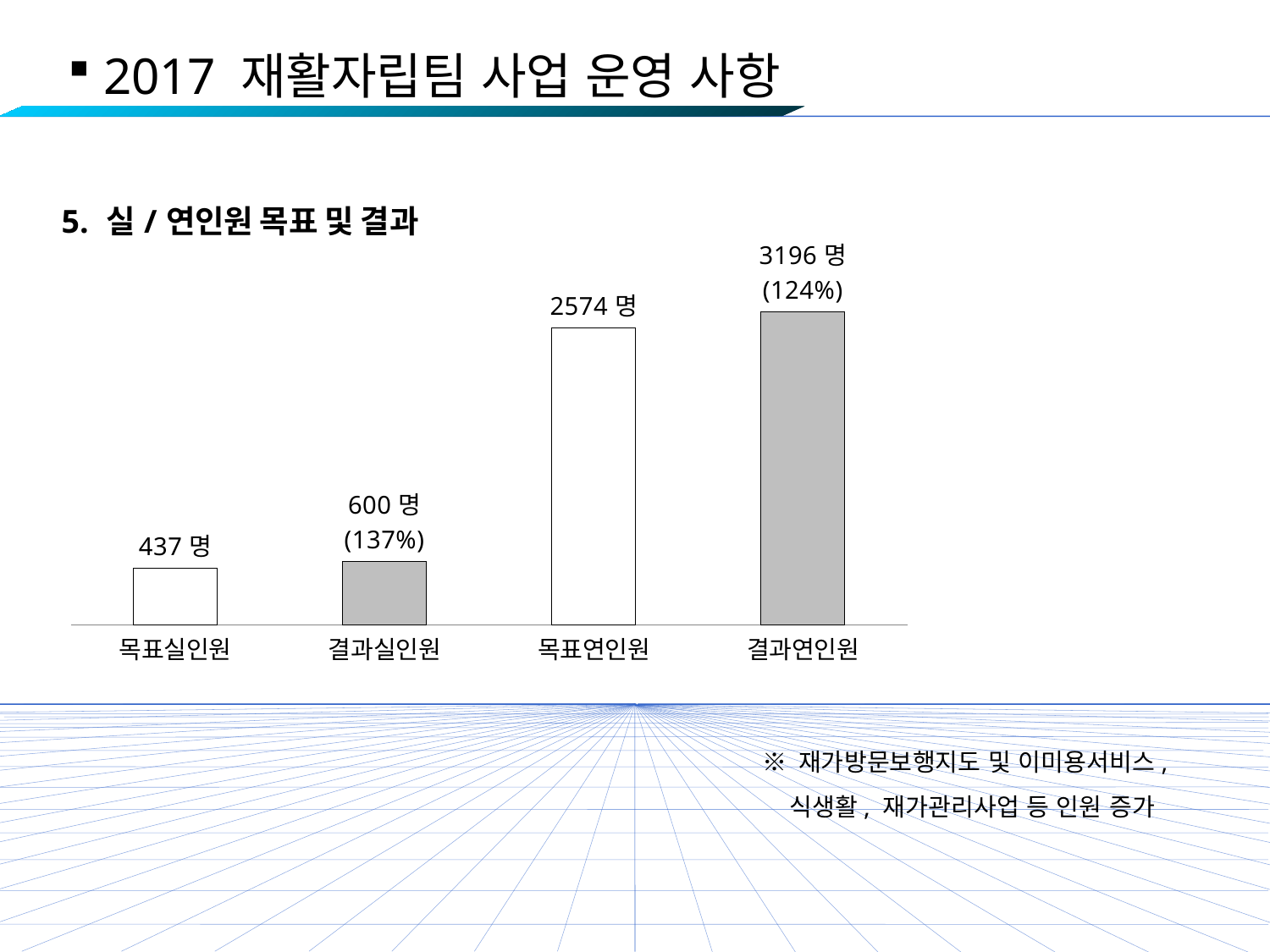
What is the difference between 결과연인원 and 목표연인원? 622 명 What percentage is shown in parentheses for 결과실인원? 137% What is the value for 결과연인원? 3196 명 What is the difference between 결과실인원 and 목표실인원? 163 명 What is the value for 결과실인원? 600 명 What percentage is shown in parentheses for 결과연인원? 124% What is the value for 목표실인원? 437 명 How many categories are shown in the chart? 4 Which category has the lowest value? 목표실인원 What is the value for 목표연인원? 2574 명 Which is larger, 목표연인원 or 결과연인원? 결과연인원 Which category has the highest value? 결과연인원